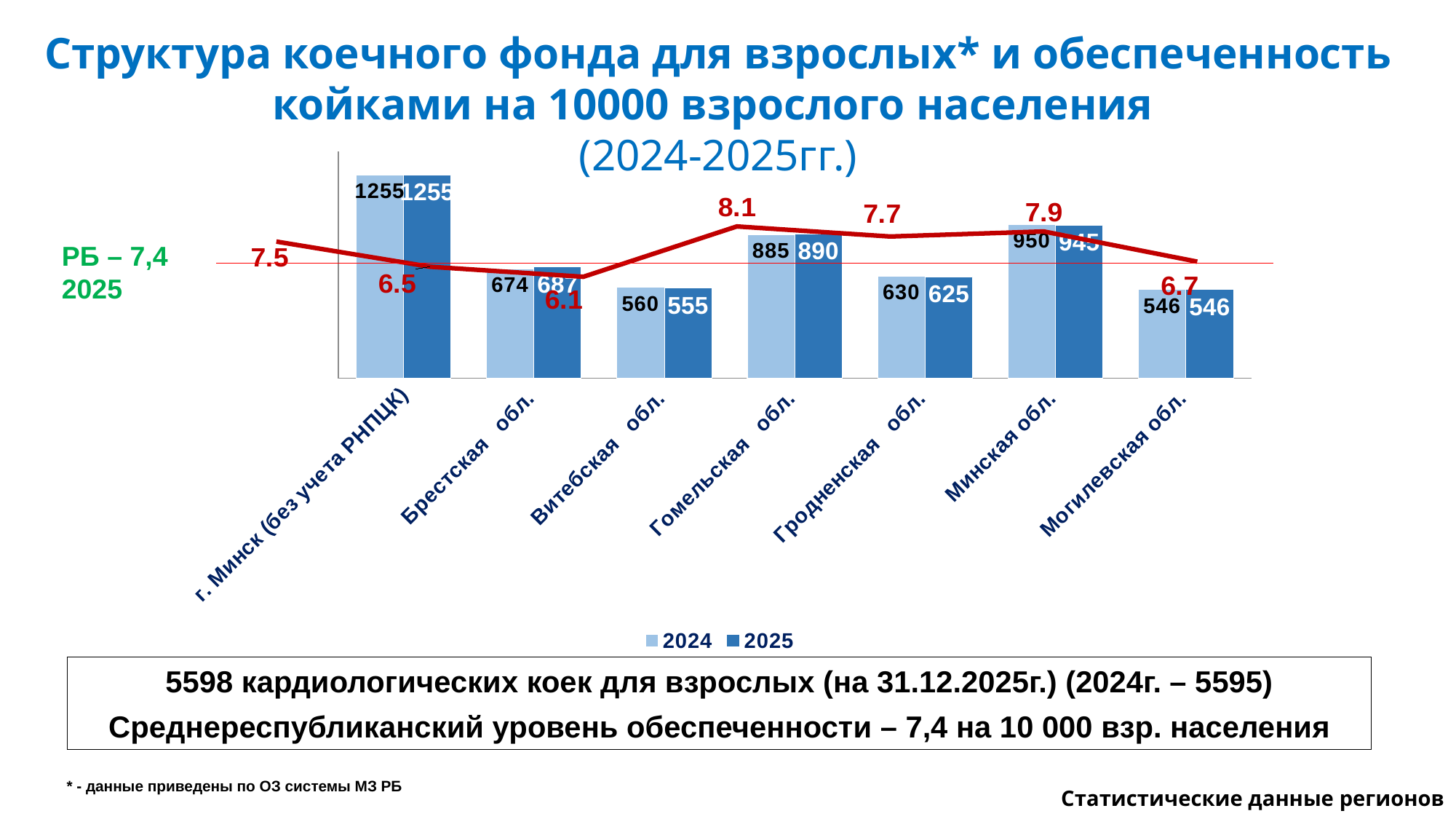
What kind of chart is used for the 2024 and 2025 values? bar chart Which region has the highest 2025 bar? г. Минск (без учета РНПЦК) What is the 2024 value for Гомельская обл.? 885 What is the difference between the 2024 and 2025 values for Минская обл.? 5 How many regions are shown on the x axis? 7 How many series does the legend list? 2 Which is larger: the 2025 value for Гомельская обл. or the 2025 value for Минская обл.? Минская обл. By how much did the value for Брестская обл. change from 2024 to 2025? 13 Which region has the lowest 2024 bar? Могилевская обл. What is the 2025 value for Брестская обл.? 687 What is the 2025 value for Витебская обл.? 555 What is the highest value labelled on the red line? 8.1